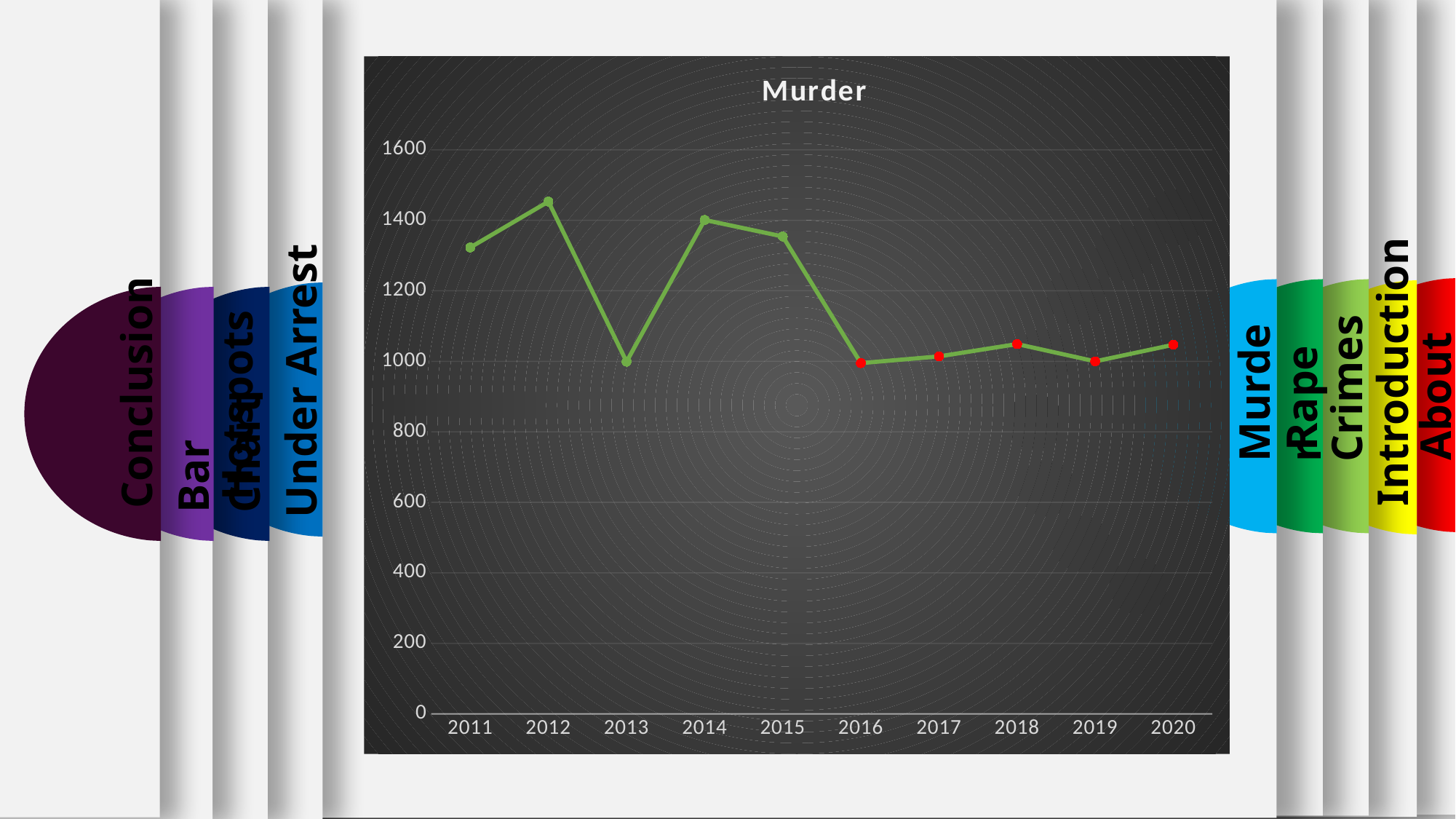
Is the value for 2012 greater or less than 1400? greater How many years are plotted on the x axis of the chart? 10 Does the value rise or fall from 2012 to 2013? fall What is the title of the chart? Murder Does the value rise or fall from 2013 to 2014? rise What kind of chart is shown on the slide? line chart Is the value for 2018 greater or less than 1200? less Which year has the highest value on the chart? 2012 Which year has the larger value, 2012 or 2013? 2012 Which year has the larger value, 2014 or 2016? 2014 Is the value for 2013 greater or less than 1200? less